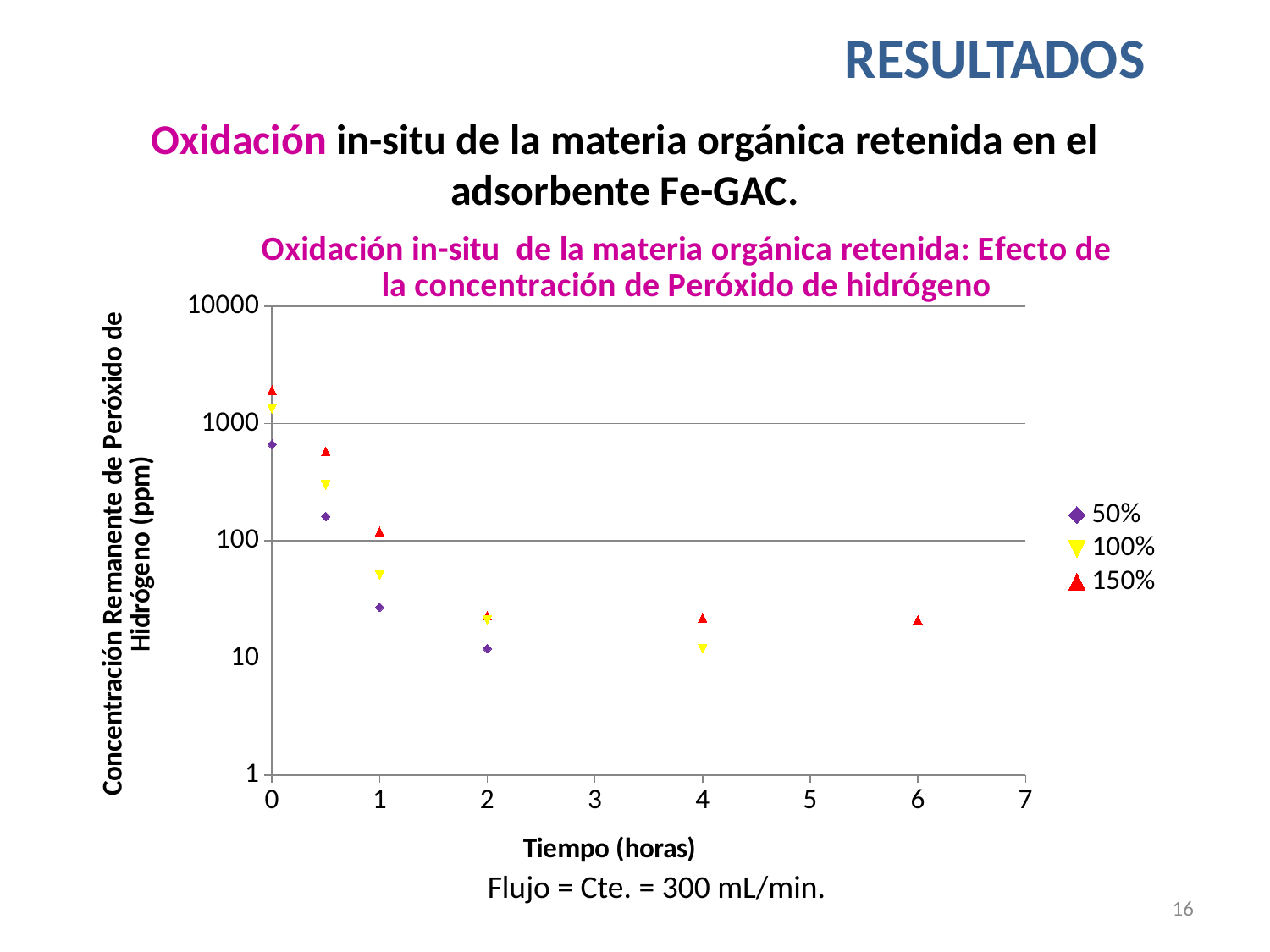
Is the value for the 150% series at 0 hours greater or less than 1000? greater Which series does the legend show with red triangles? 150% Do the values of the 50% series rise or fall as time increases? Fall At 0 hours, which series has the highest concentration? 150% How many data points are plotted for the 150% series? 6 Is the value for the 100% series at 1 hour greater or less than 100? less What kind of chart is shown on the slide? Scatter chart Is the value for the 50% series at 0 hours greater or less than 1000? less How many series does the legend list? 3 At 0.5 hours, which is larger: the value for 150% or the value for 100%? 150% What is the label of the x axis? Tiempo (horas)